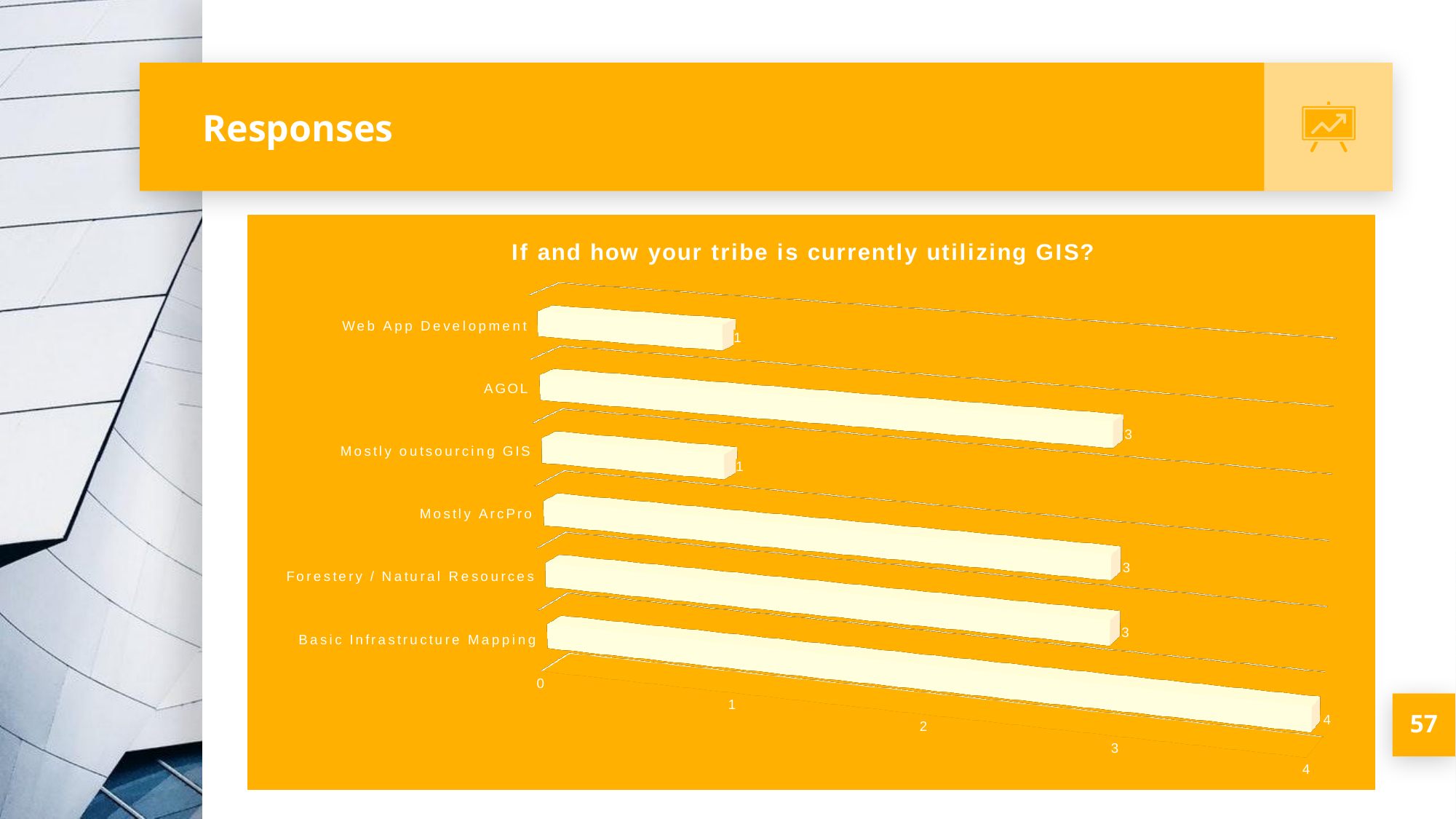
What is the title of the chart? If and how your tribe is currently utilizing GIS? What is the difference between the values for AGOL and Web App Development? 2 What is the value for Basic Infrastructure Mapping? 4 What kind of chart is shown on the slide? Bar chart What is the value for AGOL? 3 How many categories are shown in the chart? 6 Which category has the highest value? Basic Infrastructure Mapping Which is larger, the value for Mostly ArcPro or the value for Mostly outsourcing GIS? Mostly ArcPro What is the value for Forestery / Natural Resources? 3 What is the value for Web App Development? 1 What is the value for Mostly outsourcing GIS? 1 What is the difference between the values for Basic Infrastructure Mapping and Mostly ArcPro? 1